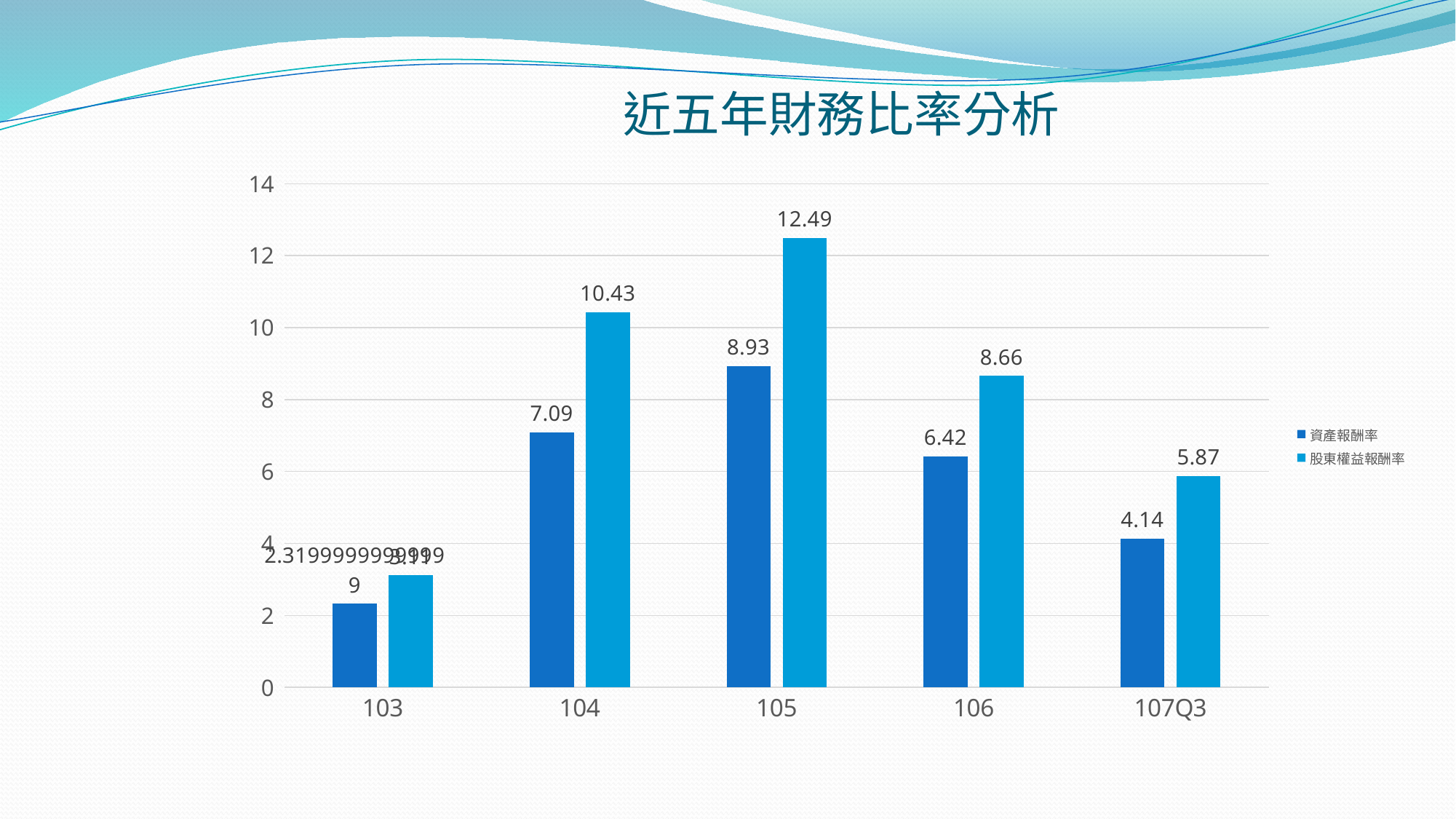
What is the value of 股東權益報酬率 for 107Q3? 5.87 What is the value of 資產報酬率 for 104? 7.09 Which category has the highest 股東權益報酬率? 105 Which is larger for 106: 資產報酬率 or 股東權益報酬率? 股東權益報酬率 What is the value of 股東權益報酬率 for 105? 12.49 What is the difference between 股東權益報酬率 and 資產報酬率 for 105? 3.56 What type of chart is shown on the slide? bar chart Is the value of 股東權益報酬率 for 103 greater or less than 4? less How many categories are shown on the x axis? 5 How many series does the legend list? 2 Which category has the lowest 資產報酬率? 103 What is the value of 資產報酬率 for 106? 6.42